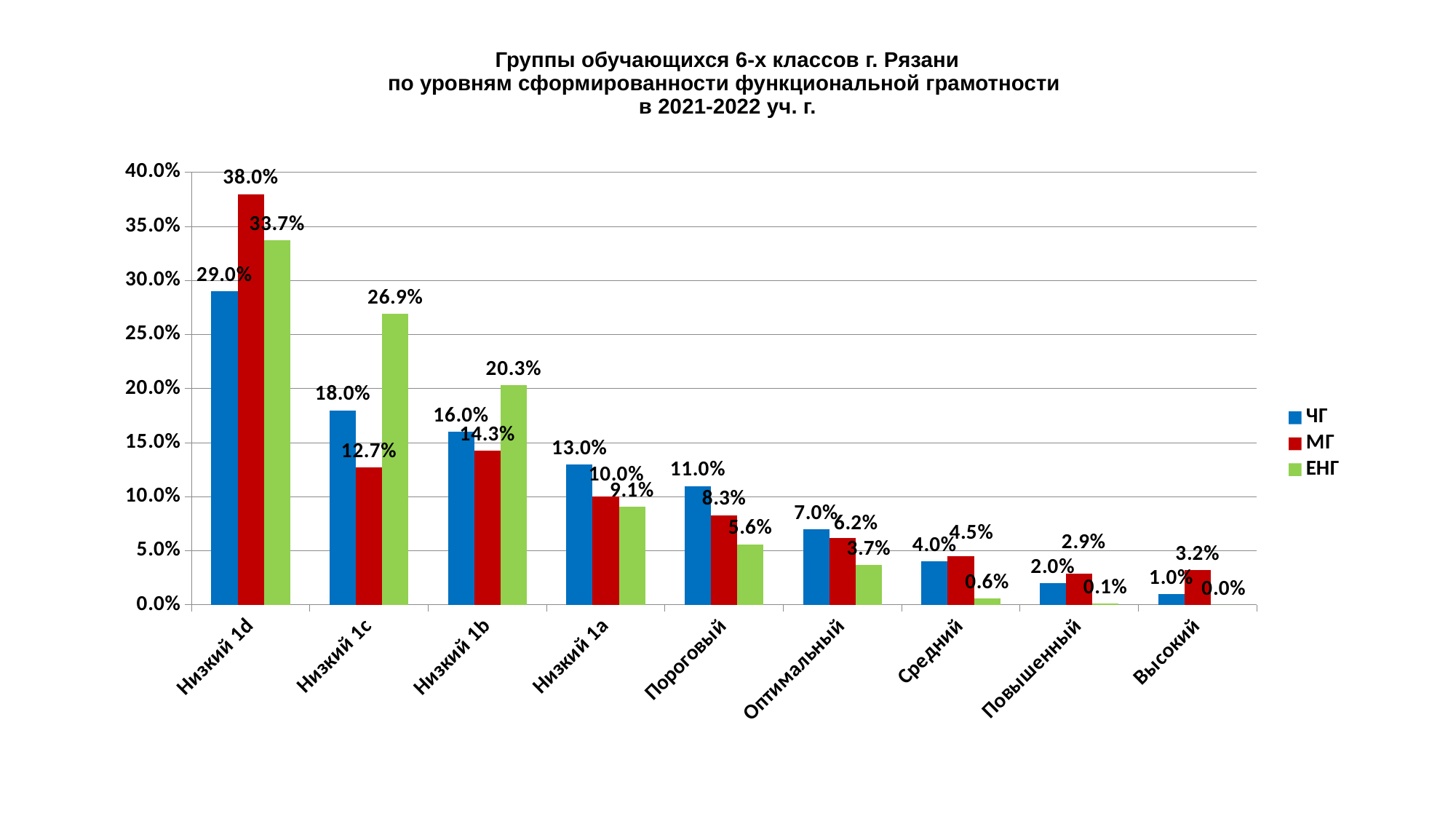
What is the difference between the МГ and ЧГ values for the category Низкий 1d? 9.0% For the category Низкий 1b, which series has the larger value, ЧГ or ЕНГ? ЕНГ Which category has the lowest value in the ЕНГ series? Высокий Which category has the highest value in the ЧГ series? Низкий 1d What is the value of the ЧГ series for the category Пороговый? 11.0% What is the value of the ЕНГ series for the category Низкий 1c? 26.9% How many series does the legend list? 3 How many categories are shown on the x axis? 9 What is the value of the МГ series for the category Низкий 1d? 38.0% What is the value of the ЕНГ series for the category Высокий? 0.0% Do the values of the ЧГ series rise or fall from Низкий 1d to Высокий along the x axis? Fall What kind of chart is shown on the slide? Bar chart